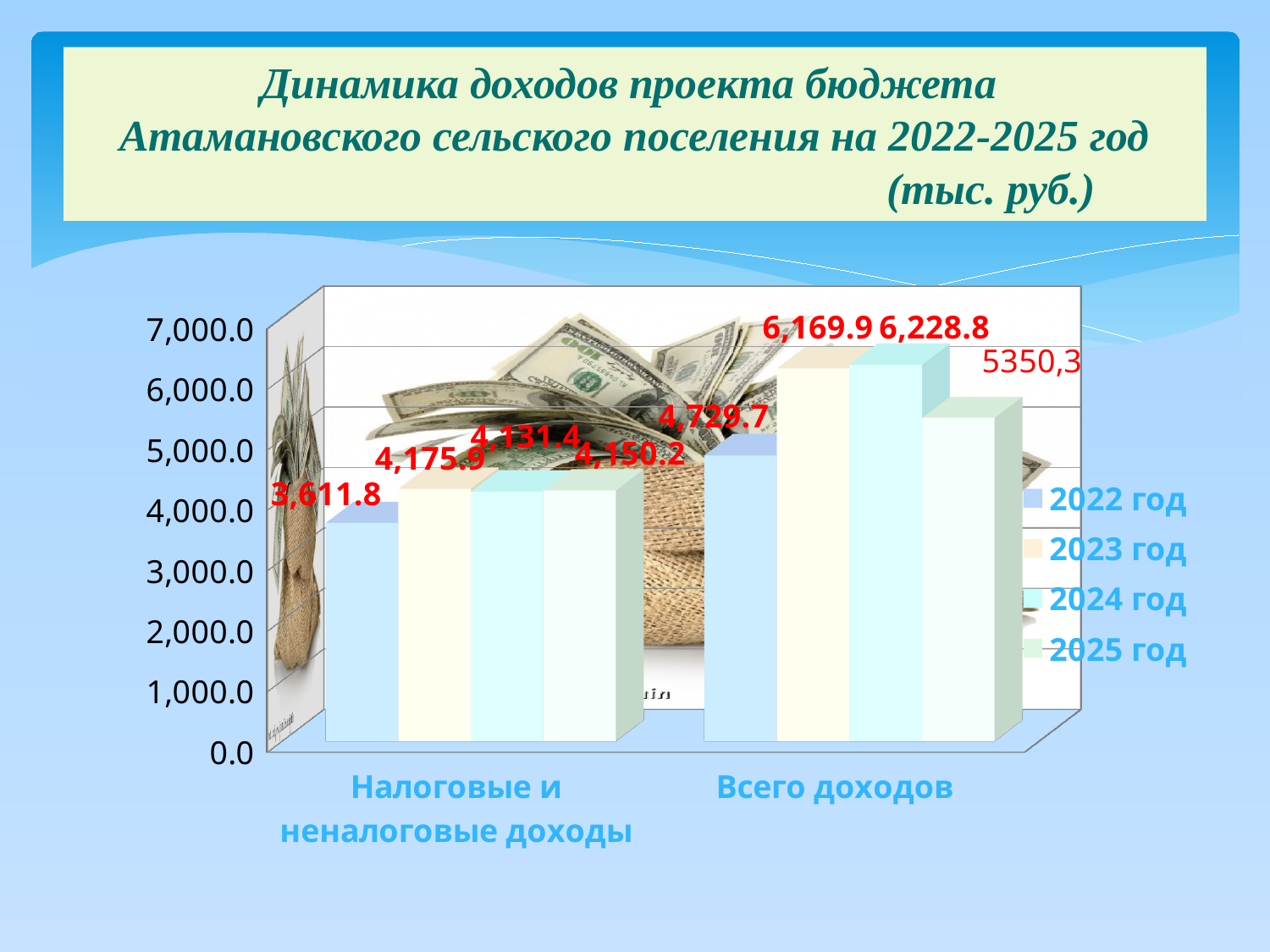
What is the value for 2024 год in the Всего доходов category? 6,228.8 What is the value for 2025 год in the Налоговые и неналоговые доходы category? 4,150.2 How many categories are shown on the x axis? 2 What kind of chart is shown on the slide? Bar chart What is the value for 2025 год in the Всего доходов category? 5350,3 What is the value for 2022 год in the Налоговые и неналоговые доходы category? 3,611.8 What is the difference between the 2023 год and 2022 год values in the Налоговые и неналоговые доходы category? 564.1 What is the value for 2023 год in the Всего доходов category? 6,169.9 Which year has the lowest value in the Всего доходов category? 2022 год Which is larger: the 2022 год value for Всего доходов or the 2023 год value for Налоговые и неналоговые доходы? 2022 год value for Всего доходов Which year has the highest value in the Налоговые и неналоговые доходы category? 2023 год How many series does the legend list? 4